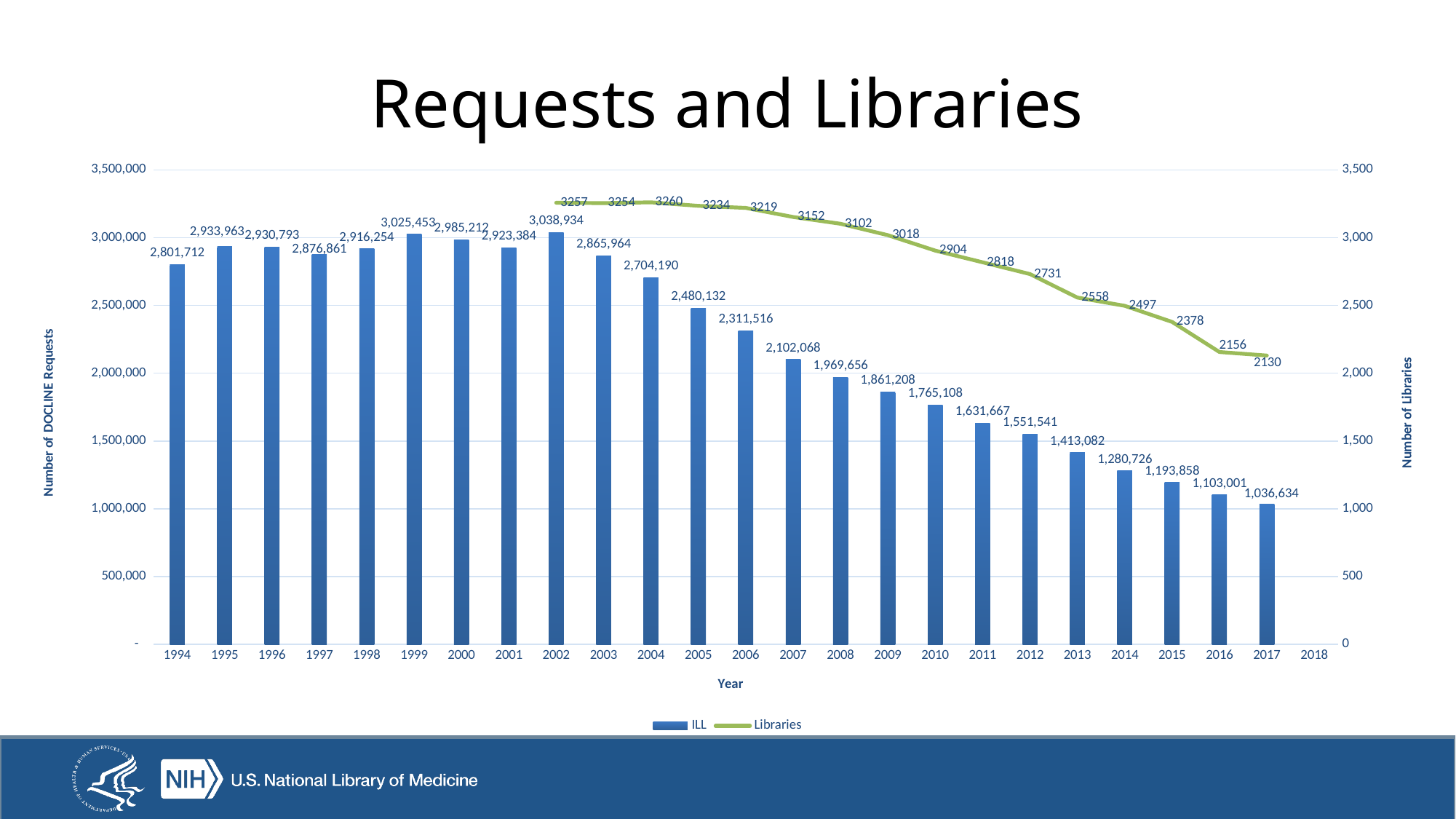
How many libraries are shown for 2010? 2904 Which year has the highest ILL value? 2002 What is the difference between the number of libraries in 2016 and in 2017? 26 How many years have an ILL bar plotted? 24 What is the ILL value for 2002? 3,038,934 Which is larger, the ILL value for 2005 or the ILL value for 2010? 2005 What is the ILL value for 2017? 1,036,634 What is the overall trend of the Libraries line from 2004 to 2017? falling Which year has the lowest number of libraries? 2017 What is the difference between the ILL value for 2002 and the ILL value for 2017? 2,002,300 How many series does the legend list? 2 Is the ILL value for 2013 greater or less than 1,500,000? less